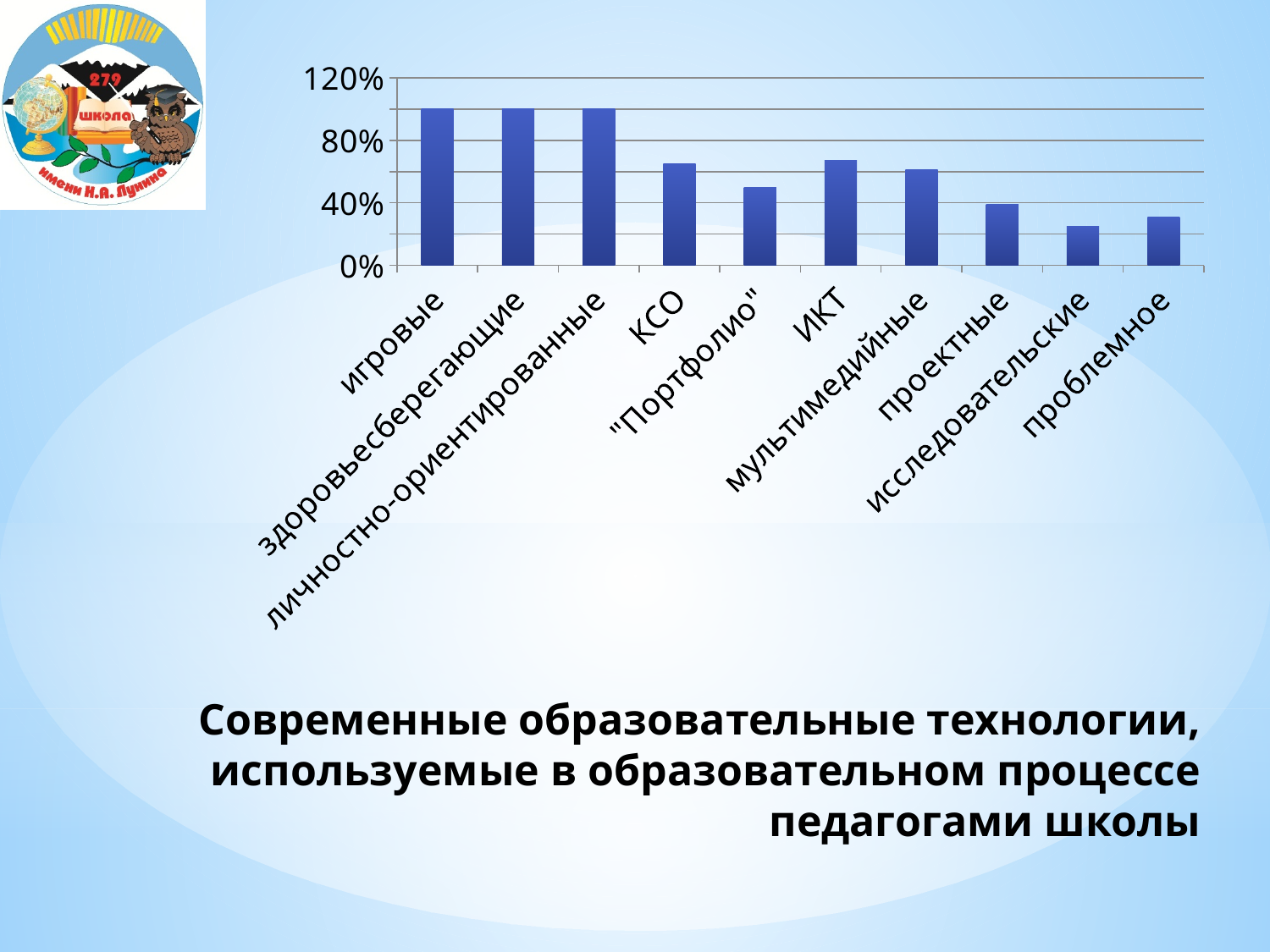
Is the value for ИКТ greater or less than 80%? less Is the value for игровые greater or less than 80%? greater Is the value for проблемное greater or less than 40%? less What kind of chart is shown on the slide? bar chart Which is larger, the value for здоровьесберегающие or the value for мультимедийные? здоровьесберегающие Which is larger, the value for КСО or the value for "Портфолио"? КСО What is the title text shown below the chart? Современные образовательные технологии, используемые в образовательном процессе педагогами школы Which is larger, the value for проектные or the value for проблемное? проектные Which category has the lowest value in the chart? исследовательские How many categories (bars) does the chart show? 10